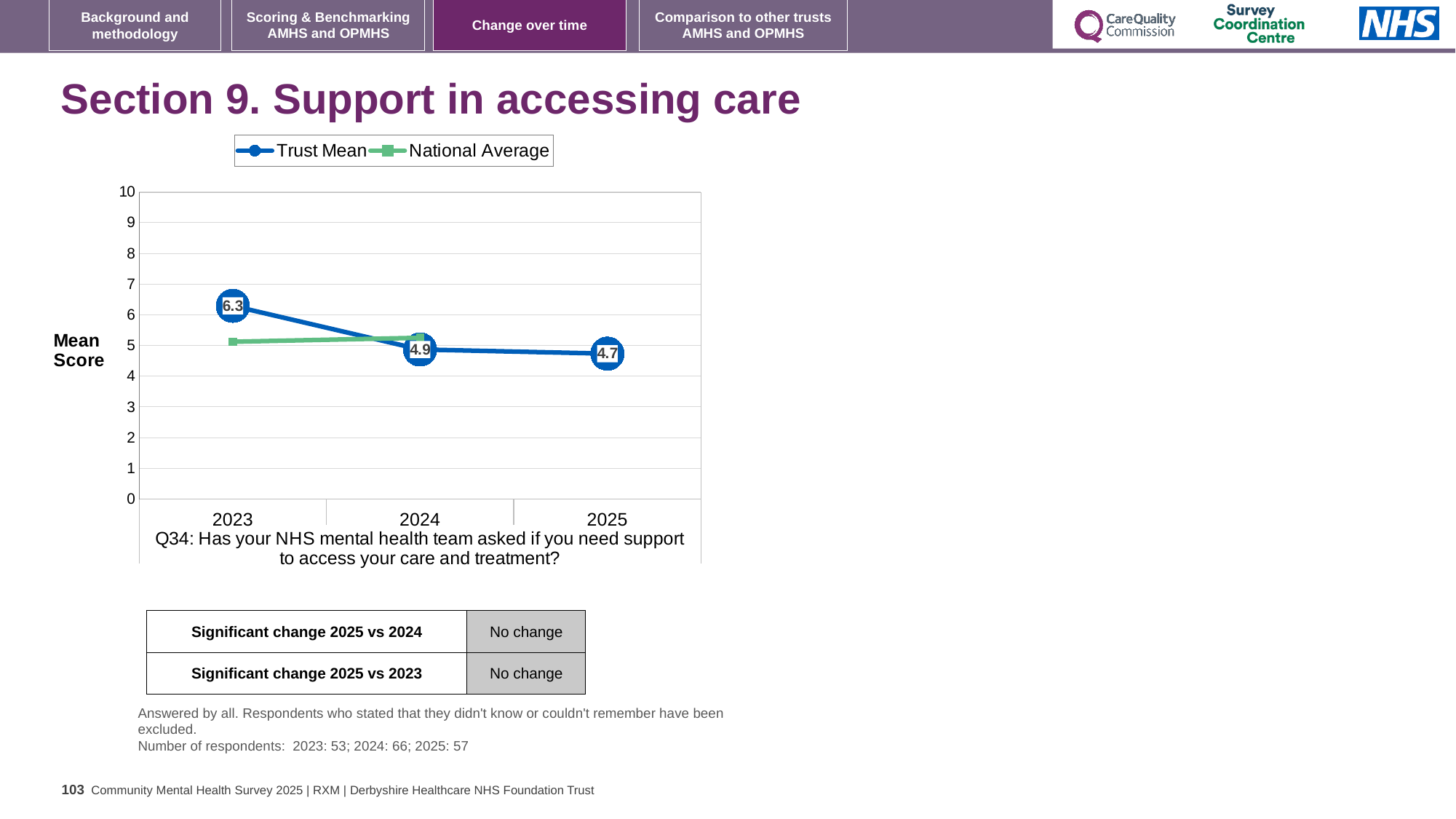
What is the Trust Mean score for 2023? 6.3 In 2023, which is larger: the Trust Mean or the National Average? Trust Mean Is the National Average value for 2023 greater or less than 6? less How many series does the chart legend list? 2 What is the difference between the Trust Mean scores for 2023 and 2025? 1.6 In which year is the Trust Mean score highest? 2023 In which year is the Trust Mean score lowest? 2025 What is the difference between the Trust Mean scores for 2023 and 2024? 1.4 How many years are shown on the x axis of the chart? 3 What is the Trust Mean score for 2025? 4.7 What kind of chart is shown on the slide? Line chart What is the Trust Mean score for 2024? 4.9